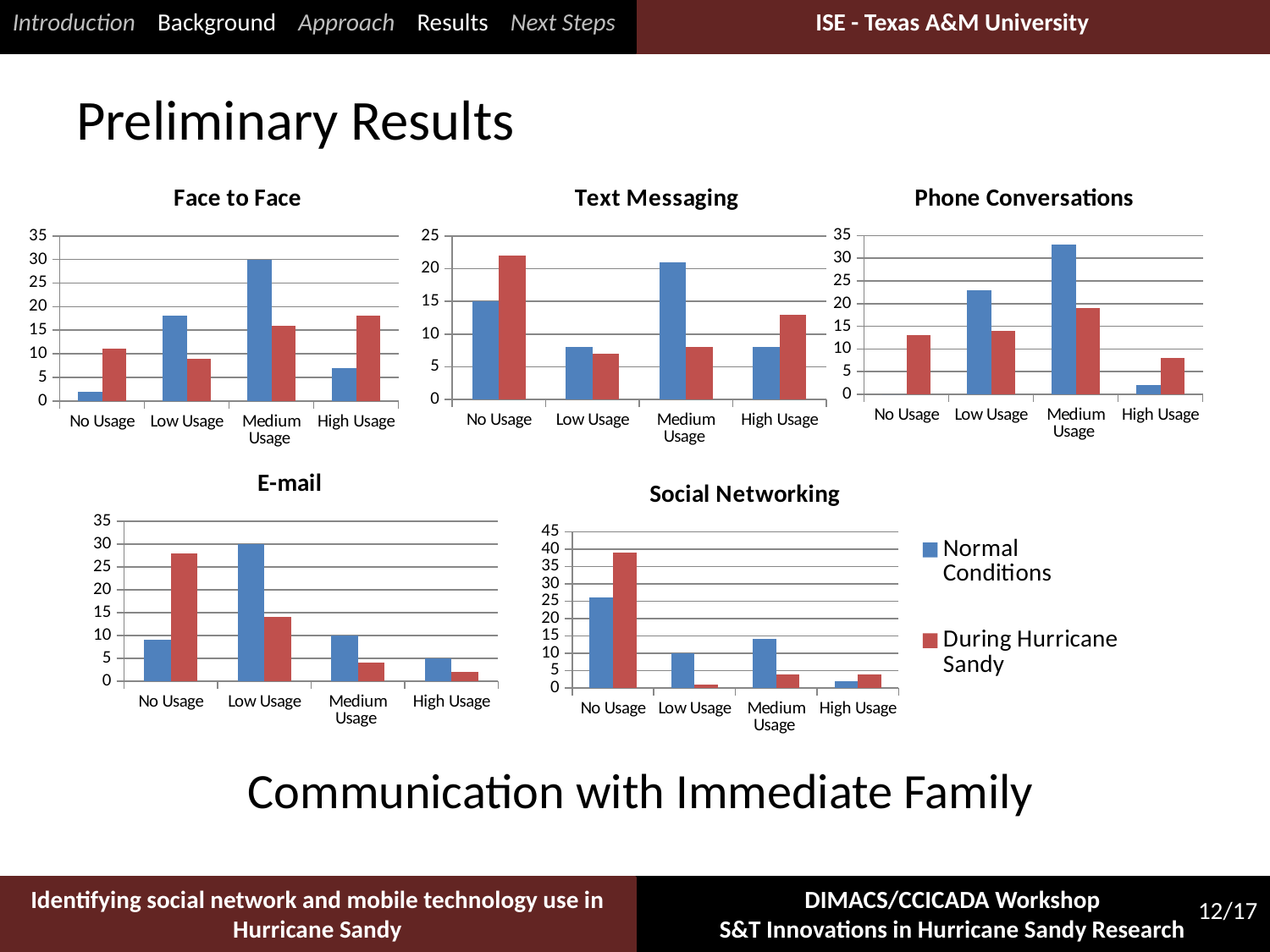
In the E-mail chart, is the During Hurricane Sandy value for No Usage greater or less than 25? greater In the Social Networking chart, which is larger for No Usage: Normal Conditions or During Hurricane Sandy? During Hurricane Sandy In the E-mail chart, what is the Normal Conditions value for Low Usage? 30 In the Text Messaging chart, is the During Hurricane Sandy value for No Usage greater or less than 20? greater In the Phone Conversations chart, which usage category has the lowest During Hurricane Sandy bar? High Usage How many usage categories are shown on the x axis of the Social Networking chart? 4 In the Face to Face chart, which usage category has the tallest Normal Conditions bar? Medium Usage In the Phone Conversations chart, which usage category has the highest Normal Conditions bar? Medium Usage In the Text Messaging chart, which is larger for Medium Usage: Normal Conditions or During Hurricane Sandy? Normal Conditions In the Face to Face chart, is the Normal Conditions value for Medium Usage greater or less than 25? greater How many series does the legend next to the Social Networking chart list? 2 What type of chart is the Phone Conversations chart? Bar chart